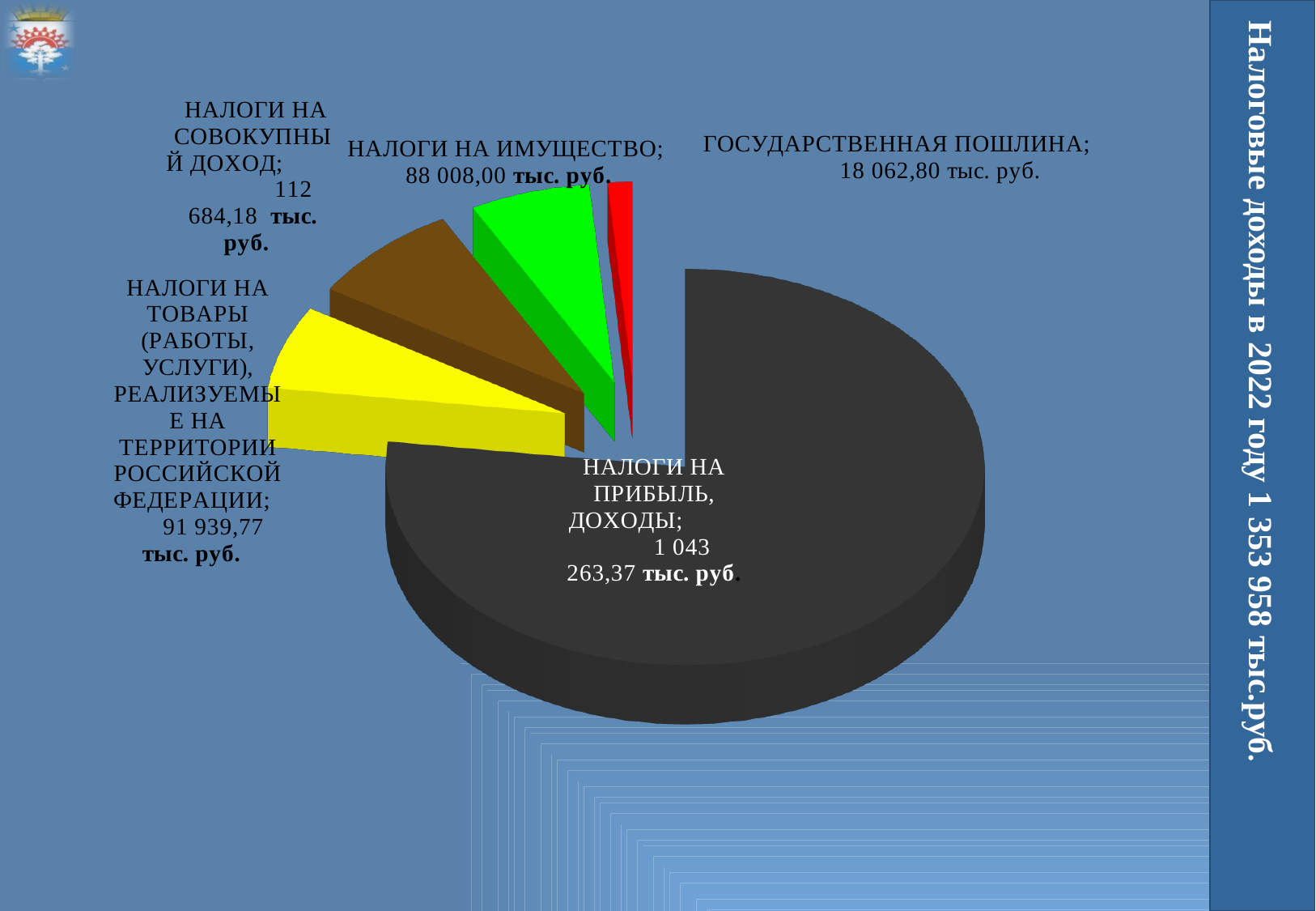
How many slices does the pie chart have? 5 Which category has the smallest slice of the pie? ГОСУДАРСТВЕННАЯ ПОШЛИНА What is the difference between НАЛОГИ НА ИМУЩЕСТВО and ГОСУДАРСТВЕННАЯ ПОШЛИНА? 69 945,20 тыс. руб. What is the value for НАЛОГИ НА ПРИБЫЛЬ, ДОХОДЫ? 1 043 263,37 тыс. руб. Which is larger: НАЛОГИ НА СОВОКУПНЫЙ ДОХОД or НАЛОГИ НА ИМУЩЕСТВО? НАЛОГИ НА СОВОКУПНЫЙ ДОХОД What is the value for ГОСУДАРСТВЕННАЯ ПОШЛИНА? 18 062,80 тыс. руб. Which category has the largest slice of the pie? НАЛОГИ НА ПРИБЫЛЬ, ДОХОДЫ What is the value for НАЛОГИ НА СОВОКУПНЫЙ ДОХОД? 112 684,18 тыс. руб. What type of chart is shown on the slide? Pie chart What is the value for НАЛОГИ НА ИМУЩЕСТВО? 88 008,00 тыс. руб. What is the difference between НАЛОГИ НА СОВОКУПНЫЙ ДОХОД and НАЛОГИ НА ТОВАРЫ (РАБОТЫ, УСЛУГИ), РЕАЛИЗУЕМЫЕ НА ТЕРРИТОРИИ РОССИЙСКОЙ ФЕДЕРАЦИИ? 20 744,41 тыс. руб. What total tax revenue for 2022 is stated in the slide title? 1 353 958 тыс.руб.